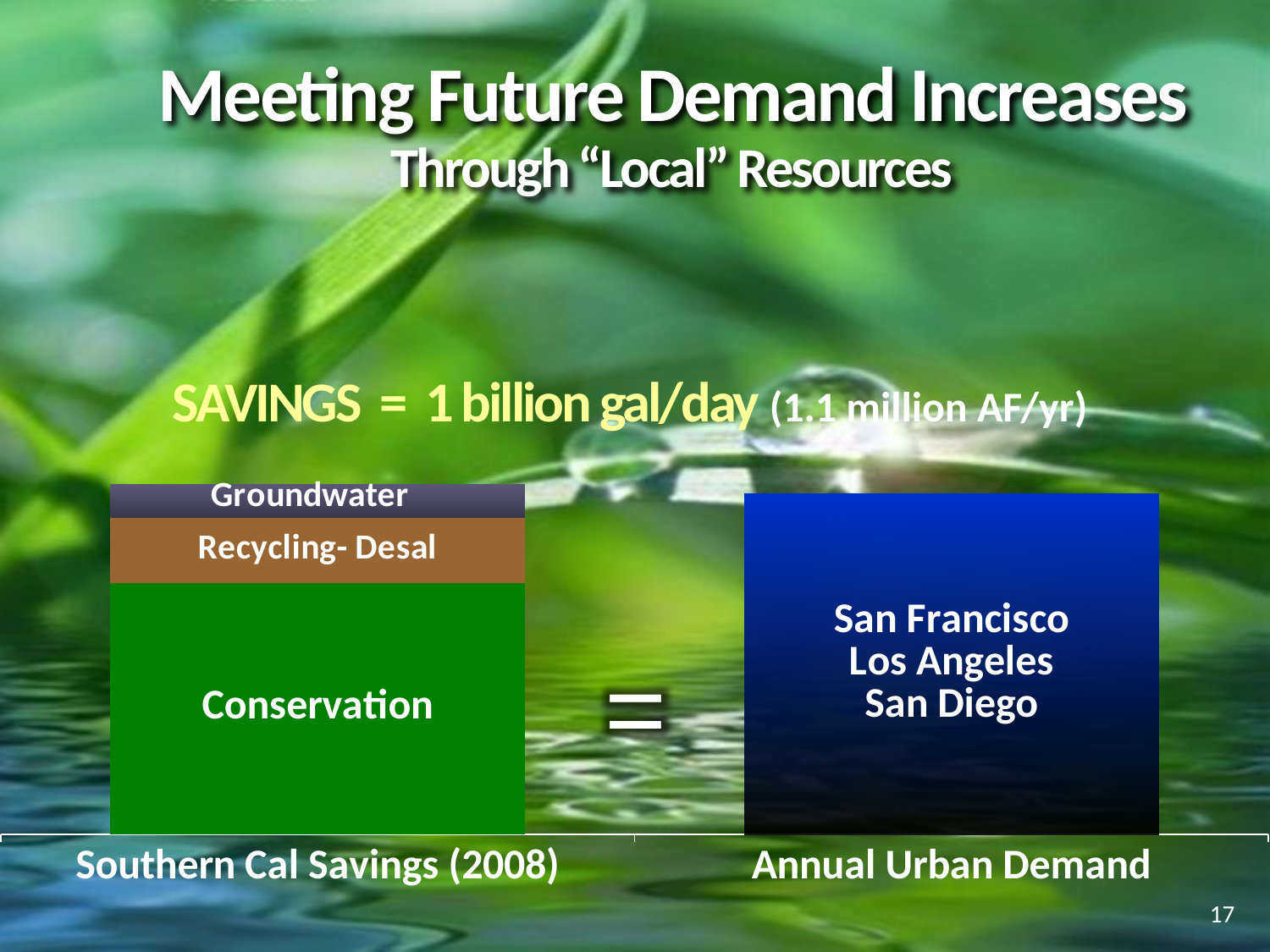
Which is larger in the Southern Cal Savings (2008) bar, the Conservation segment or the Recycling- Desal segment? Conservation What kind of chart is shown on the slide? Stacked bar chart How many bars (categories) are shown along the bottom of the chart? 2 Which segment of the Southern Cal Savings (2008) bar is the smallest? Groundwater According to the chart, how does the height of the Southern Cal Savings (2008) bar compare to the Annual Urban Demand bar? They are equal What total savings does the slide state the Southern Cal Savings bar represents? 1 billion gal/day (1.1 million AF/yr) Which segment of the Southern Cal Savings (2008) bar is the largest? Conservation Which cities are listed inside the Annual Urban Demand bar? San Francisco, Los Angeles, San Diego What colour is the Conservation segment of the Southern Cal Savings (2008) bar? Green What are the two category labels shown beneath the bars? Southern Cal Savings (2008) and Annual Urban Demand How many segments make up the Southern Cal Savings (2008) bar? 3 Which is larger in the Southern Cal Savings (2008) bar, the Recycling- Desal segment or the Groundwater segment? Recycling- Desal